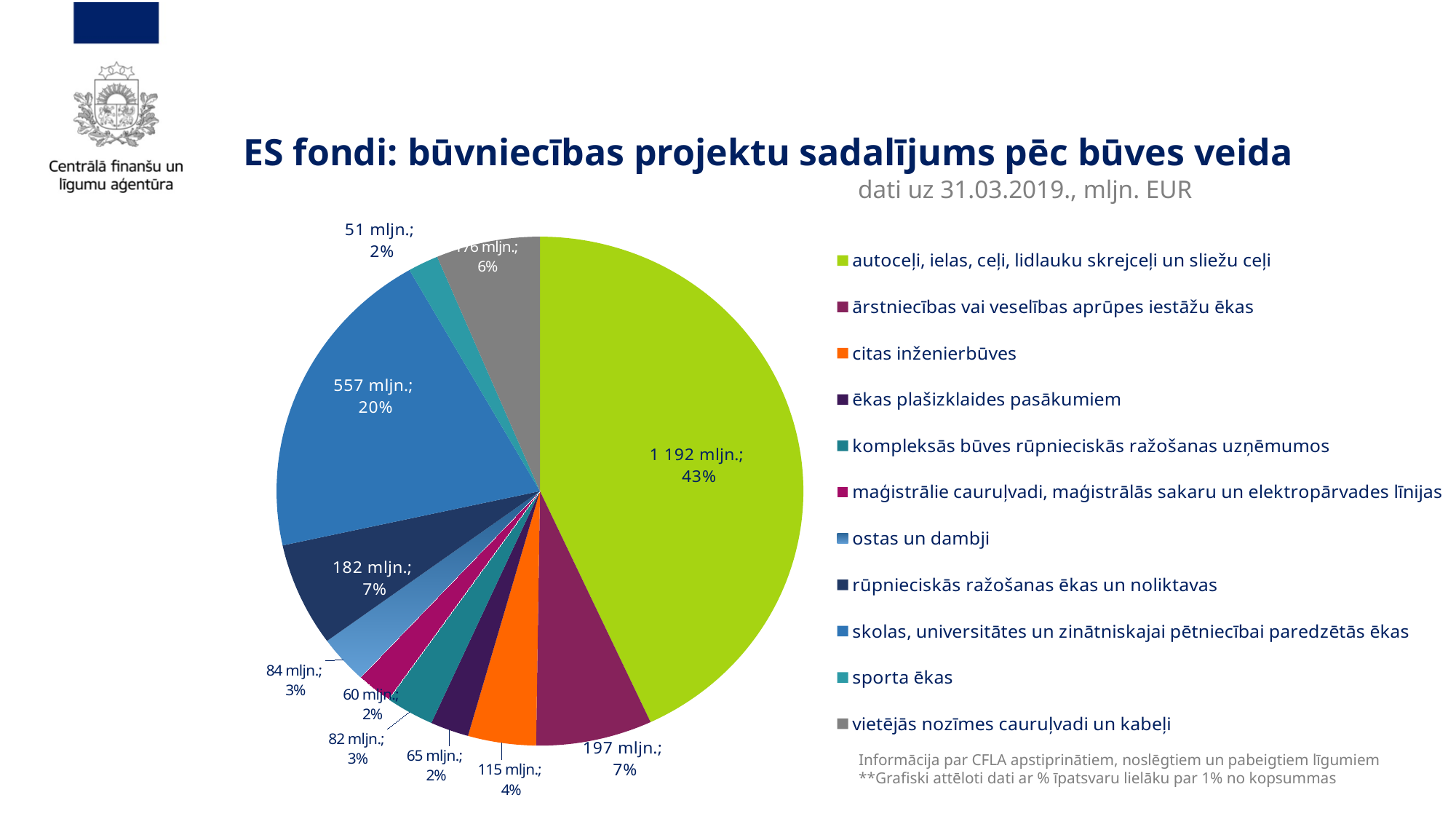
What is the title of the chart on the slide? ES fondi: būvniecības projektu sadalījums pēc būves veida Which category has the largest slice of the pie? autoceļi, ielas, ceļi, lidlauku skrejceļi un sliežu ceļi Which is larger: the slice for 'ostas un dambji' or the slice for 'maģistrālie cauruļvadi, maģistrālās sakaru un elektropārvades līnijas'? ostas un dambji What share of the pie does 'vietējās nozīmes cauruļvadi un kabeļi' represent? 6% How many categories does the legend of the pie chart list? 11 What kind of chart is shown on the slide? pie chart Which category has the smallest slice of the pie? sporta ēkas What share of the pie does 'autoceļi, ielas, ceļi, lidlauku skrejceļi un sliežu ceļi' represent? 43% What value is shown for 'rūpnieciskās ražošanas ēkas un noliktavas'? 182 mljn. What value is shown for the slice 'skolas, universitātes un zinātniskajai pētniecībai paredzētās ēkas'? 557 mljn. What share of the pie does 'citas inženierbūves' represent? 4% What is the difference in value between 'ārstniecības vai veselības aprūpes iestāžu ēkas' (197 mljn.) and 'rūpnieciskās ražošanas ēkas un noliktavas' (182 mljn.)? 15 mljn.